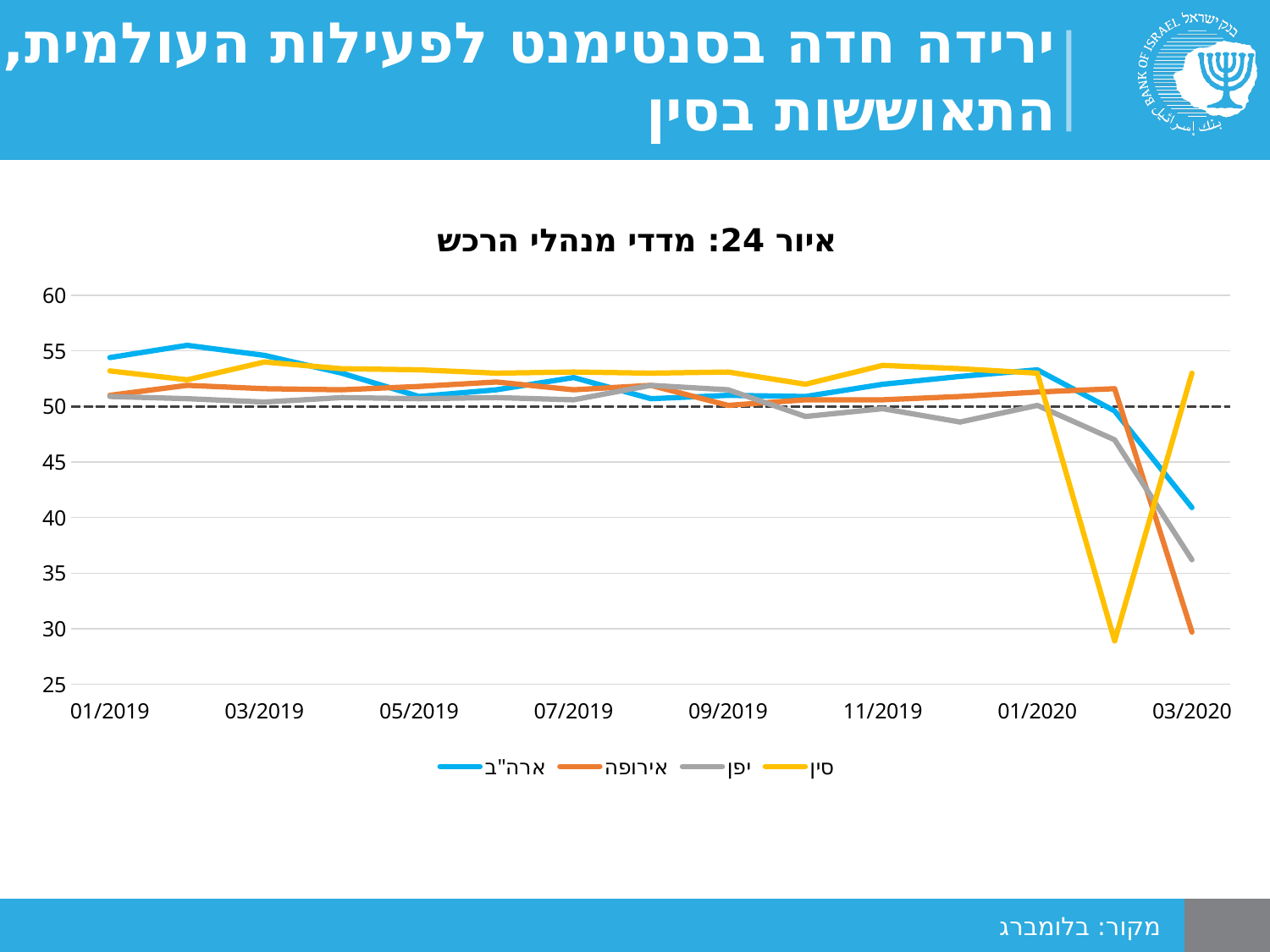
Is the value for סין in 03/2020 greater or less than 50? greater What is the title of the chart? איור 24: מדדי מנהלי הרכש What kind of chart is shown on the slide? line chart Is the value for אירופה in 03/2020 greater or less than 35? less Which series has the lowest value in 02/2020? סין Which series has the highest value in 03/2020? סין Which series is drawn in yellow? סין How many series does the legend list? 4 Is the value for סין in 02/2020 greater or less than 30? less Does the value for ארה"ב rise or fall from 01/2020 to 03/2020? fall In 02/2020, which is larger: the value for ארה"ב or the value for סין? ארה"ב